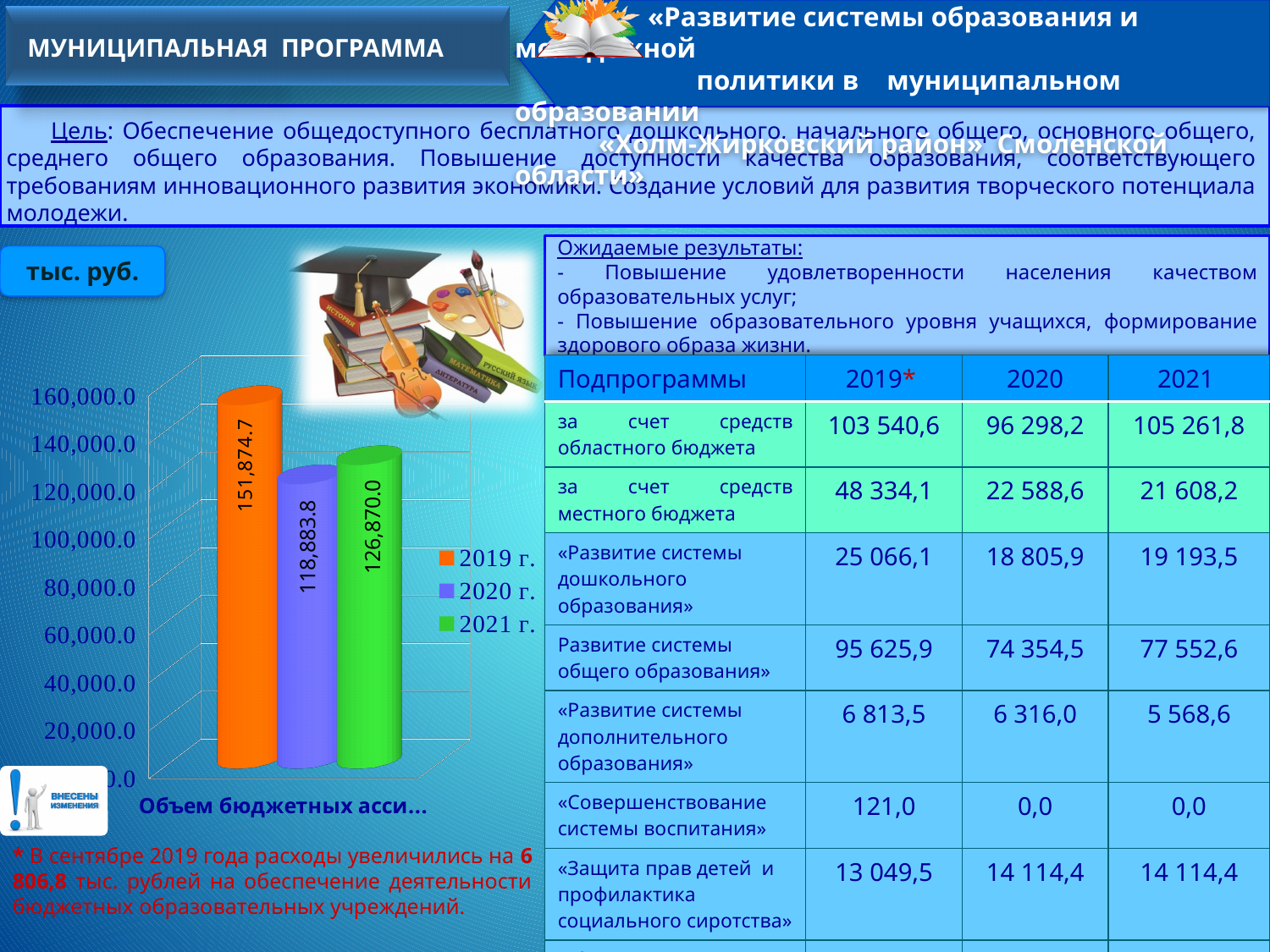
Which year has the lowest bar in the chart? 2020 г. What type of chart is shown on the slide? bar chart What is the difference between the 2021 г. and 2020 г. values in the chart? 7,986.2 What is the value of the 2020 г. bar in the chart? 118,883.8 What is the difference between the 2019 г. and 2020 г. values in the chart? 32,990.9 Which year has the highest bar in the chart? 2019 г. How many series does the chart legend list? 3 Is the value for 2019 г. greater or less than 140,000.0? greater Which is larger in the chart, the 2021 г. value or the 2020 г. value? 2021 г. What is the value of the 2021 г. bar in the chart? 126,870.0 What is the value of the 2019 г. bar in the chart? 151,874.7 What colour is the 2021 г. bar in the chart? green